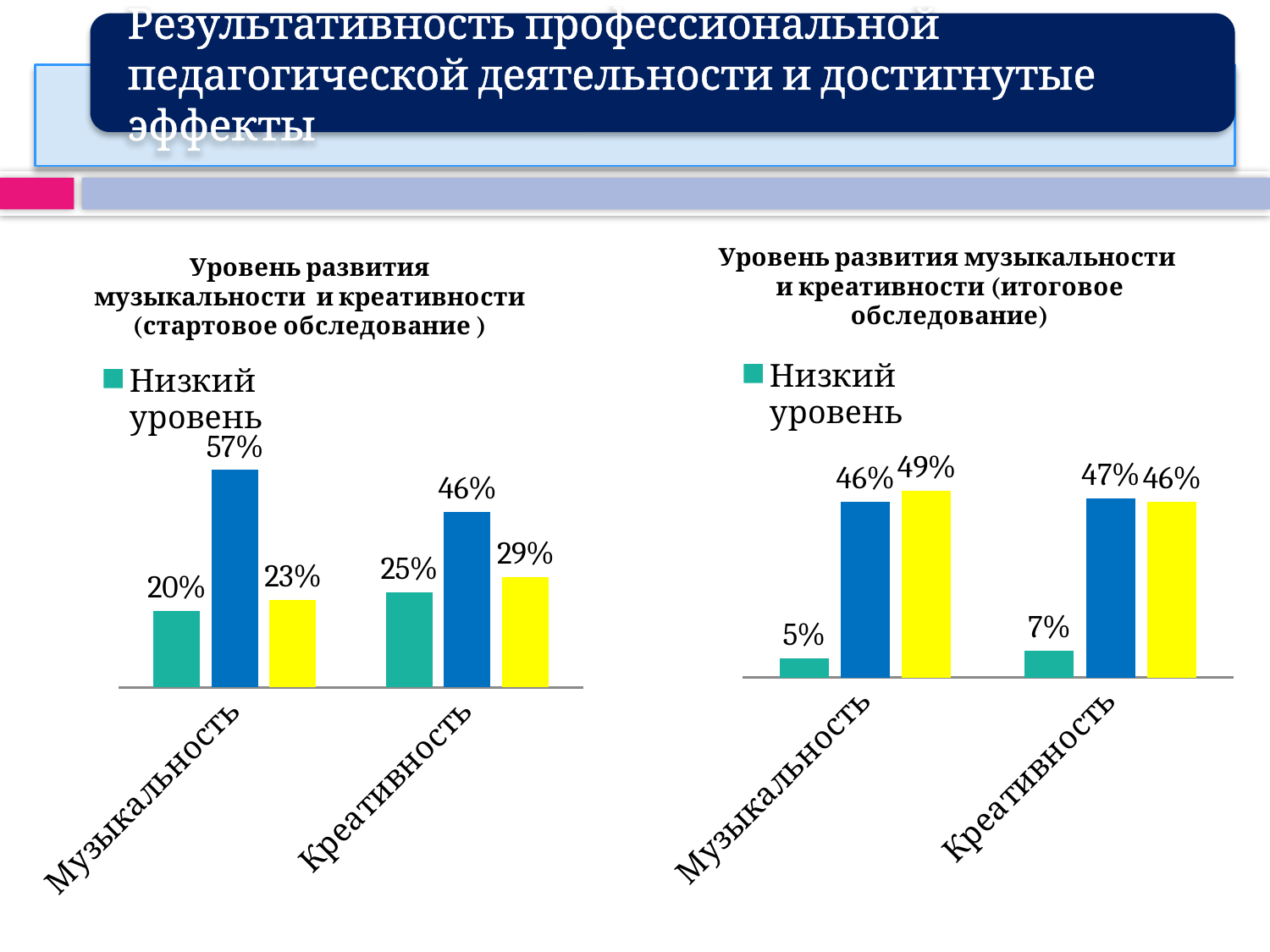
In the right chart (итоговое обследование), what is the value of Низкий уровень for Музыкальность? 5% In the left chart (стартовое обследование), what is the value of Низкий уровень for Креативность? 25% Which chart shows the larger Низкий уровень value for Музыкальность, the left (стартовое) or the right (итоговое)? left (стартовое обследование) In the right chart (итоговое обследование), what is the lowest value shown for Креативность? 7% Which series name is shown in the legend of the right chart (итоговое обследование)? Низкий уровень In the left chart (стартовое обследование), what is the difference between the Низкий уровень values for Креативность and Музыкальность? 5% What is the title of the left chart? Уровень развития музыкальности и креативности (стартовое обследование) In the left chart (стартовое обследование), what is the highest value shown for Музыкальность? 57% In the left chart (стартовое обследование), what is the value of Низкий уровень for Музыкальность? 20% What type of chart is the right chart (итоговое обследование)? bar chart How many categories are shown on the x axis of the left chart (стартовое обследование)? 2 In the right chart (итоговое обследование), what is the value of Низкий уровень for Креативность? 7%